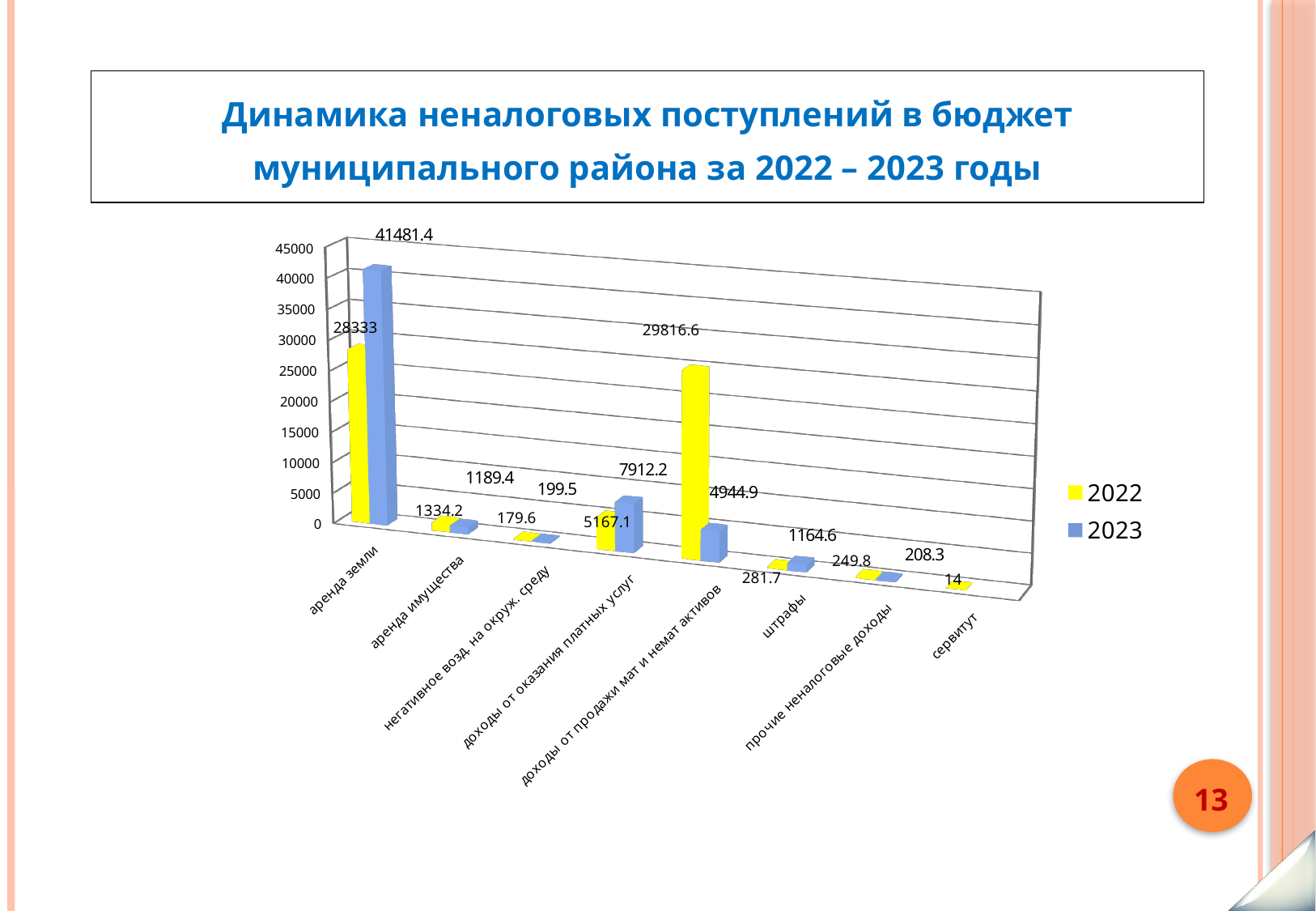
What is the 2022 value for доходы от продажи мат и немат активов? 29816.6 Which category has the highest 2022 value? доходы от продажи мат и немат активов How many categories are shown on the x axis? 8 What is the 2023 value for аренда земли? 41481.4 How many series does the legend list? 2 What is the difference between the 2023 and 2022 values for аренда земли? 13148.4 What kind of chart is shown on the slide? bar chart Which category has the highest 2023 value? аренда земли What is the difference between the 2023 and 2022 values for доходы от оказания платных услуг? 2745.1 For доходы от продажи мат и немат активов, which year has the larger value, 2022 or 2023? 2022 What is the 2023 value for штрафы? 1164.6 Which category has the lowest 2022 value? сервитут